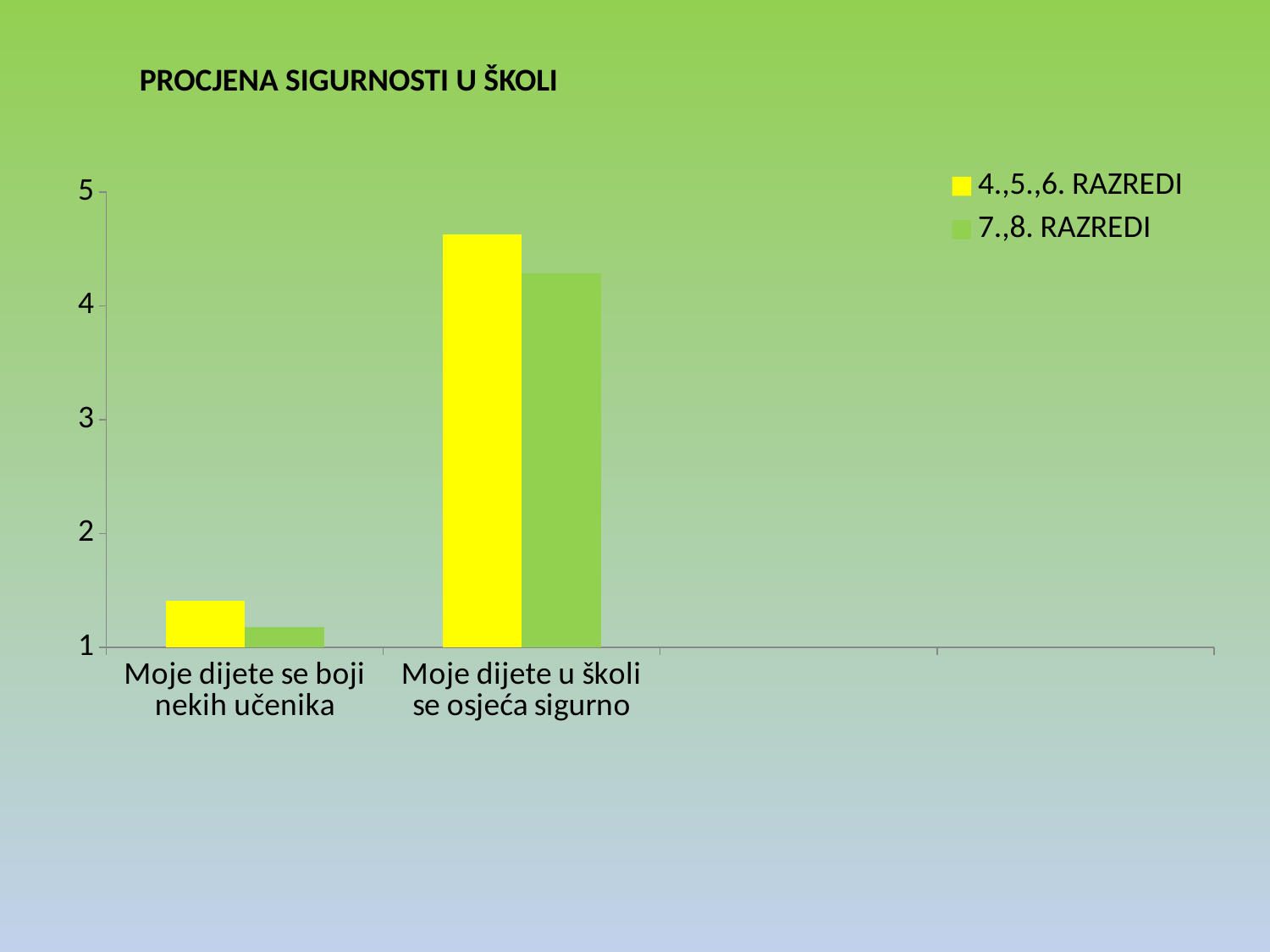
Is the value for 7.,8. RAZREDI in the category 'Moje dijete u školi se osjeća sigurno' greater or less than 4? greater Is the value for 4.,5.,6. RAZREDI in the category 'Moje dijete u školi se osjeća sigurno' greater or less than 4? greater How many categories are shown on the x axis of the chart? 2 What kind of chart is shown on the slide? bar chart Is the value for 7.,8. RAZREDI in the category 'Moje dijete se boji nekih učenika' greater or less than 2? less How many series does the legend list? 2 For the category 'Moje dijete se boji nekih učenika', which series has the larger value, 4.,5.,6. RAZREDI or 7.,8. RAZREDI? 4.,5.,6. RAZREDI Which category has the lowest value for the 7.,8. RAZREDI series? Moje dijete se boji nekih učenika Which category has the highest value for the 4.,5.,6. RAZREDI series? Moje dijete u školi se osjeća sigurno Which series is shown in yellow in the chart? 4.,5.,6. RAZREDI What is the title of the chart? PROCJENA SIGURNOSTI U ŠKOLI For the category 'Moje dijete u školi se osjeća sigurno', which series has the larger value, 4.,5.,6. RAZREDI or 7.,8. RAZREDI? 4.,5.,6. RAZREDI